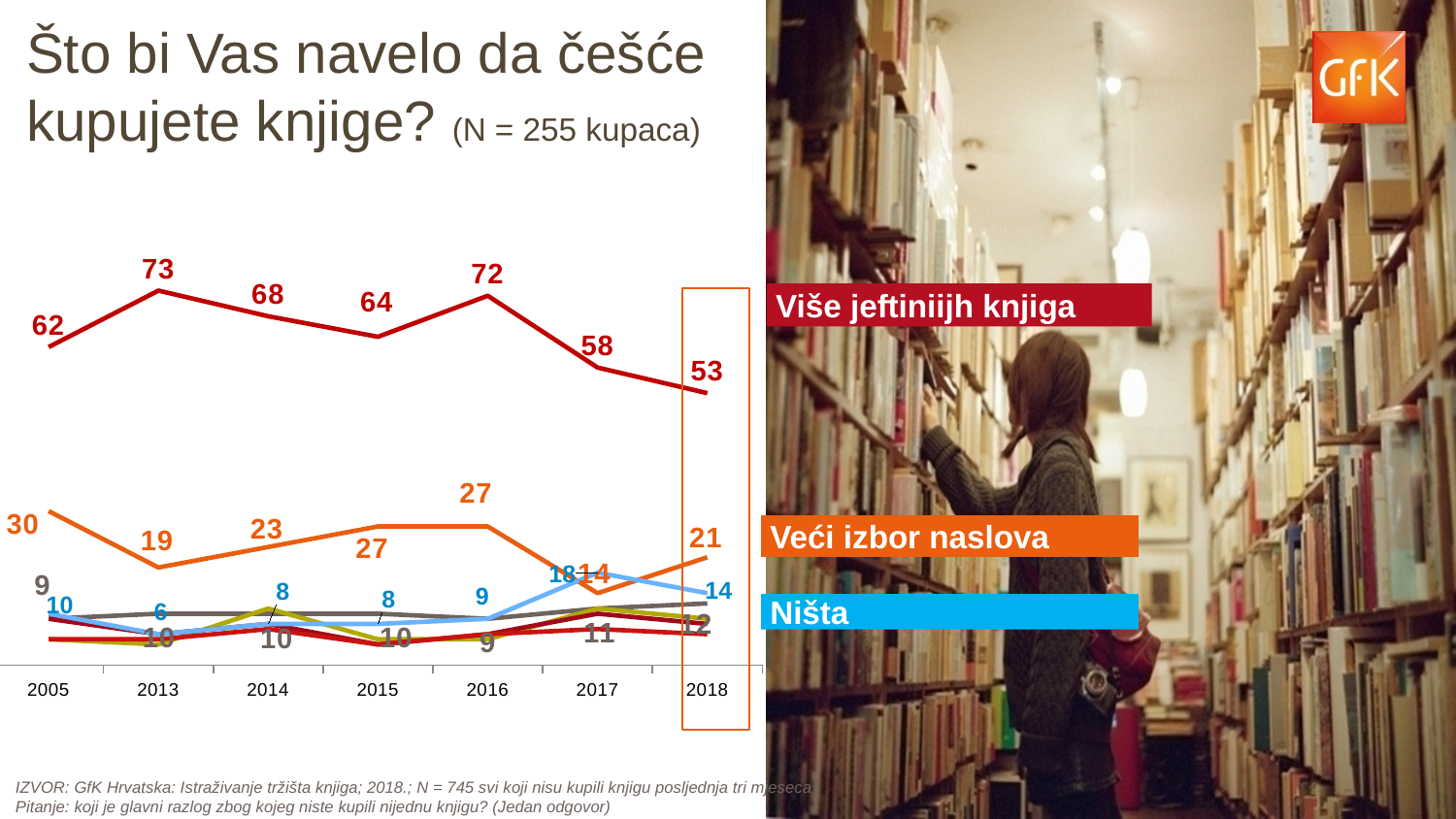
What is the value for "Više jeftiniijh knjiga" in 2013? 73 What is the value for "Veći izbor naslova" in 2018? 21 What is the difference between the 2013 and 2018 values for "Više jeftiniijh knjiga"? 20 What is the value for "Ništa" in 2018? 14 What kind of chart is shown on the slide? line chart In which year is the value for "Više jeftiniijh knjiga" highest? 2013 Does the value for "Više jeftiniijh knjiga" rise or fall from 2016 to 2018? fall What is the value for "Više jeftiniijh knjiga" in 2018? 53 What is the value for "Veći izbor naslova" in 2005? 30 In which year is the value for "Više jeftiniijh knjiga" lowest? 2018 In 2016, which is larger: "Više jeftiniijh knjiga" or "Veći izbor naslova"? Više jeftiniijh knjiga How many years are shown on the x axis of the chart? 7